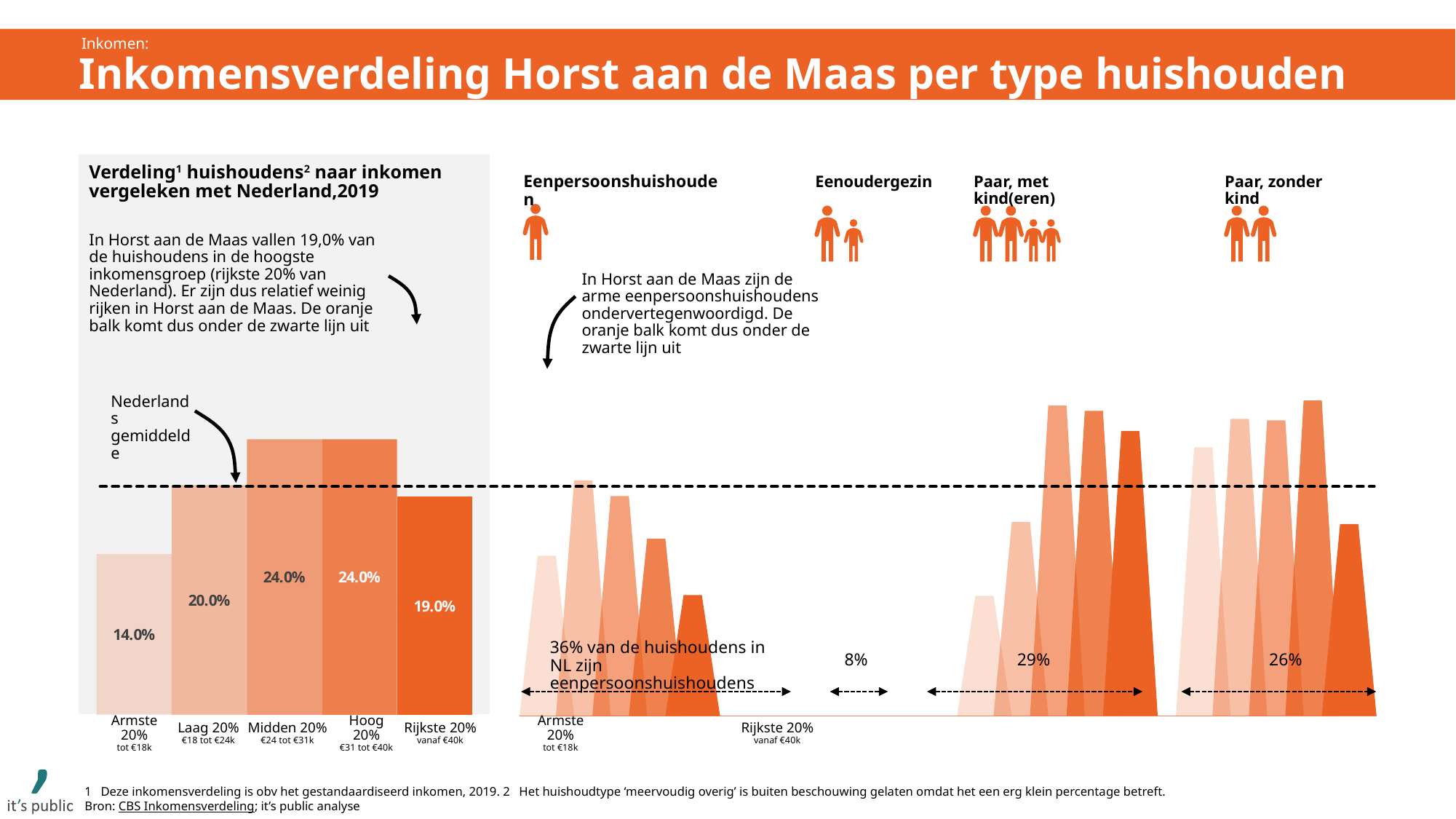
In the left chart 'Verdeling huishoudens naar inkomen vergeleken met Nederland, 2019', what is the value for Armste 20%? 14.0% In the left chart, what is the difference between the values for Midden 20% and Armste 20%? 10.0% In the left chart, what is the value for Laag 20%? 20.0% How many income groups are shown in the left chart? 5 In the right-hand chart, what share of households in NL are eenpersoonshuishoudens? 36% In the left chart, which income group has the lowest value? Armste 20% In the left chart, what is the value for Rijkste 20%? 19.0% In the right-hand chart, what percentage is shown for Eenoudergezin? 8% What kind of chart is the left chart 'Verdeling huishoudens naar inkomen vergeleken met Nederland, 2019'? bar chart In the left chart, what does the dashed horizontal line represent? Nederlands gemiddelde In the right-hand chart, which is larger: the percentage for 'Paar, met kind(eren)' or for 'Paar, zonder kind'? Paar, met kind(eren) In the left chart, which is larger: the value for Laag 20% or the value for Rijkste 20%? Laag 20%